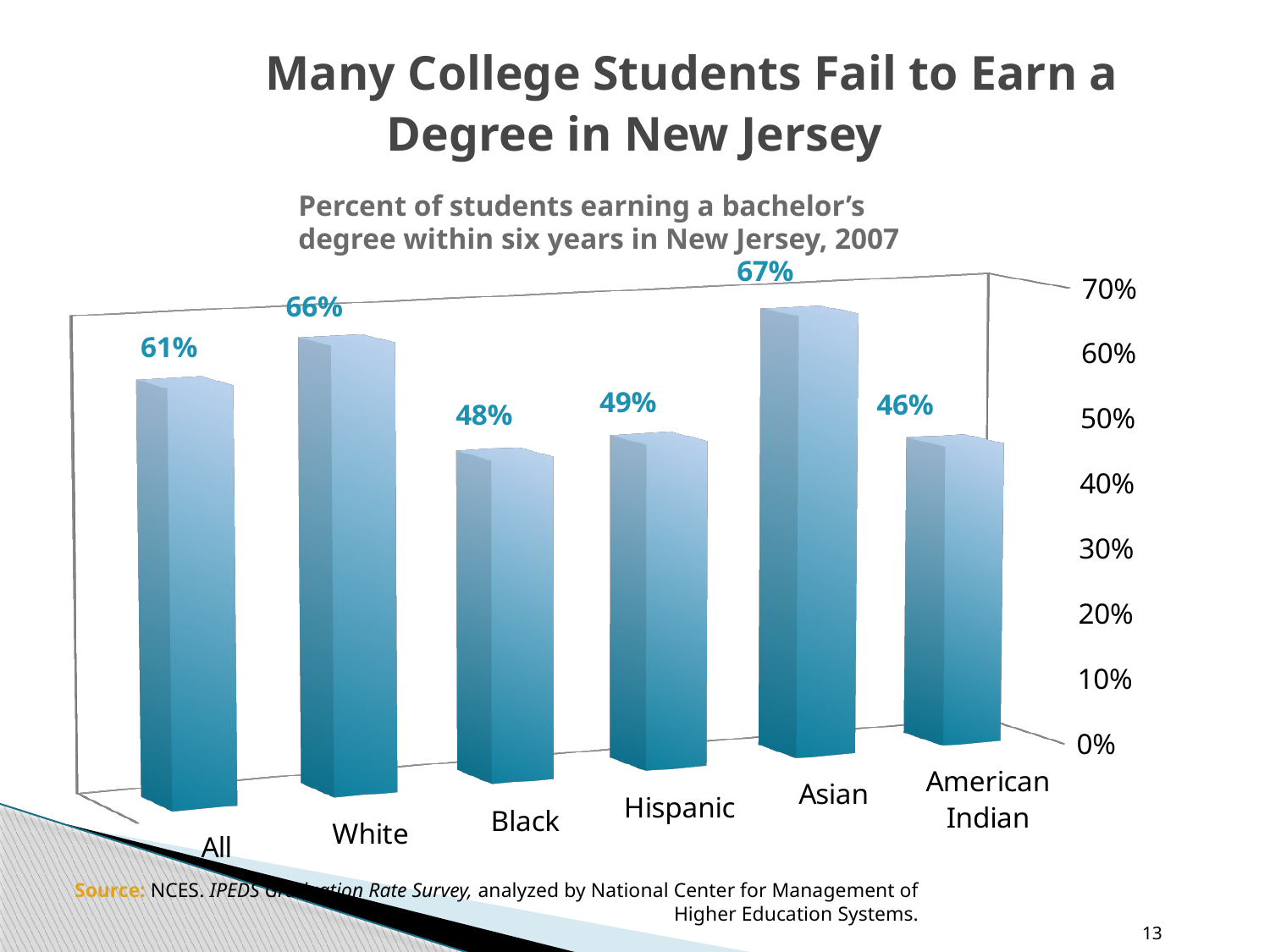
Which group has the lowest percent of students earning a bachelor's degree within six years? American Indian Which group has the highest percent of students earning a bachelor's degree within six years? Asian Is the value for White students greater or less than 50%? greater How many groups are shown on the chart? 6 What is the value shown for Black students? 48% What is the difference in percentage points between Asian and American Indian students? 21 What is the value shown for Asian students? 67% What percent of all students earned a bachelor's degree within six years in New Jersey in 2007? 61% Which group has a higher value, Hispanic or American Indian? Hispanic What is the difference in percentage points between White and Black students? 18 What kind of chart is shown on the slide? bar chart What is the title of the chart? Percent of students earning a bachelor's degree within six years in New Jersey, 2007